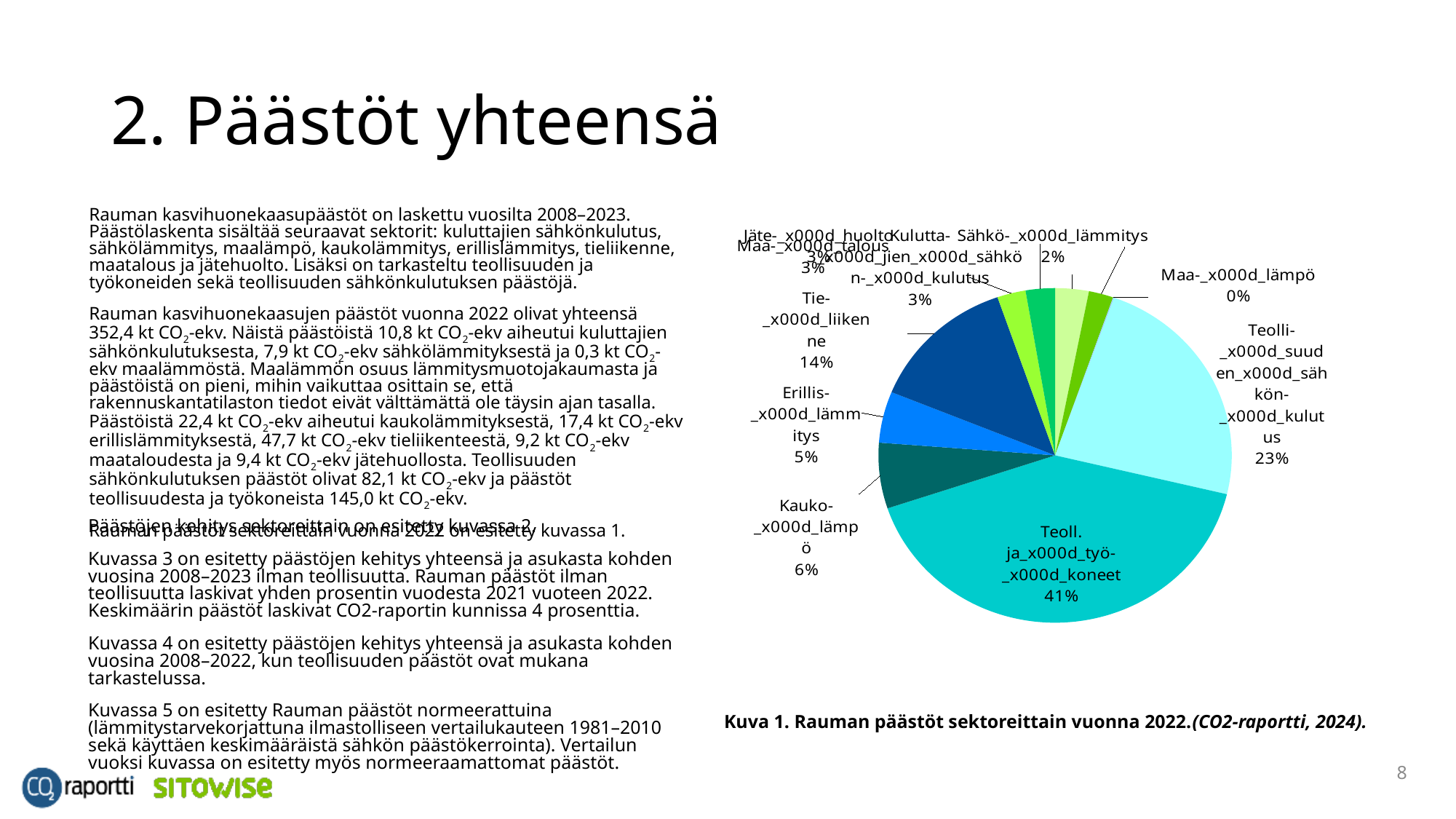
What percentage is shown for Teollisuuden sähkön kulutus? 23% What percentage is shown for Erillislämmitys? 5% What percentage is shown for Sähkölämmitys? 2% What share of the pie does the Teoll. ja työkoneet slice have? 41% How many percentage points larger is the Teoll. ja työkoneet slice than the Teollisuuden sähkön kulutus slice? 18 percentage points How many slices does the pie chart have? 10 What kind of chart is shown on the slide? pie chart What percentage is shown for Kaukolämpö? 6% Which sector has the smallest slice of the pie? Maalämpö What percentage is shown for Tieliikenne? 14% Which sector has the largest slice of the pie? Teoll. ja työkoneet Which slice is larger, Tieliikenne or Kaukolämpö? Tieliikenne